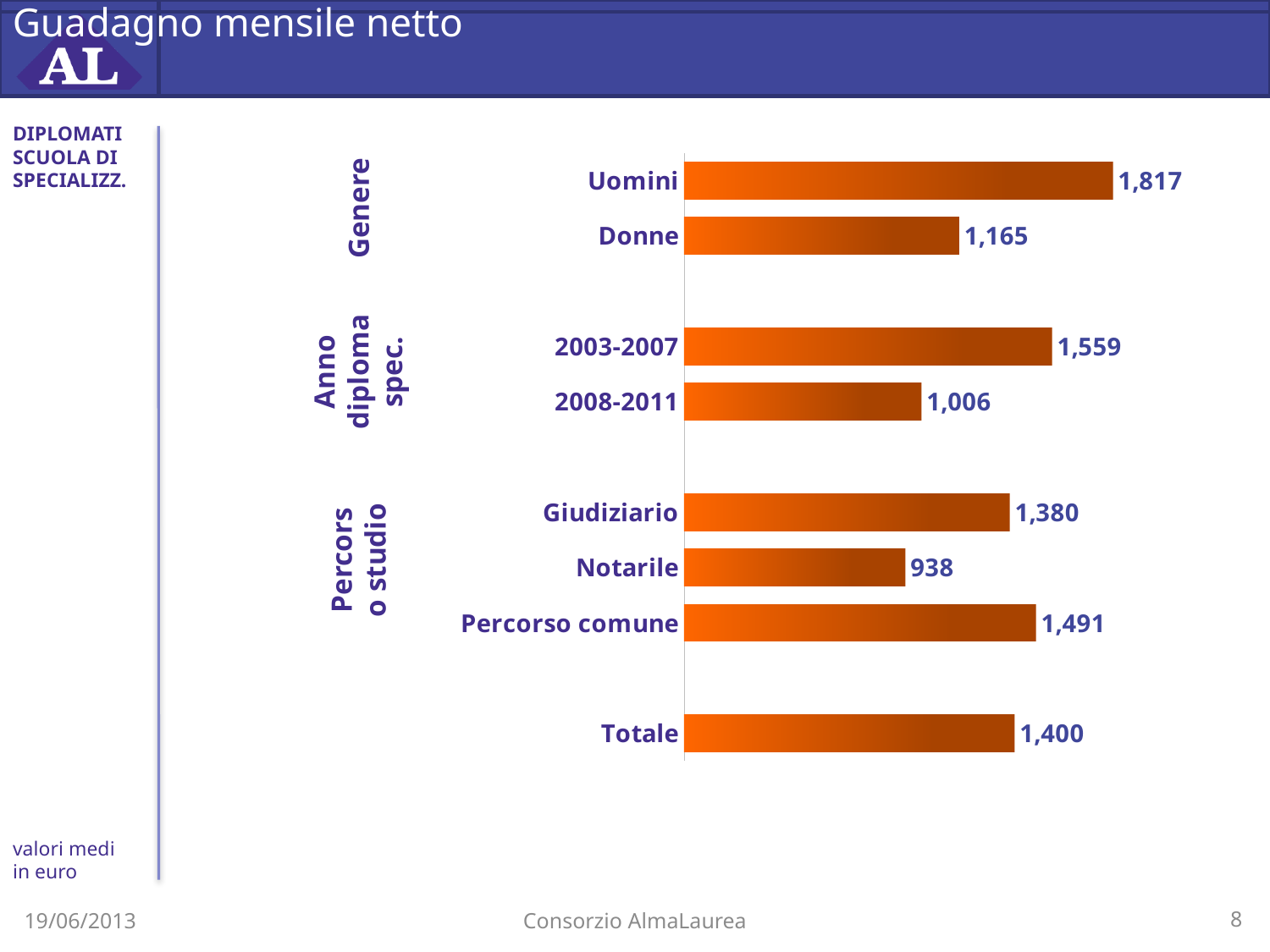
What is the value for Notarile? 938 Which category has the highest value? Uomini What is the value for Donne? 1,165 How many bars are plotted in the chart? 8 Which is larger, the value for Giudiziario or the value for Percorso comune? Percorso comune What is the value for 2008-2011? 1,006 What is the value for Totale? 1,400 What kind of chart is shown on the slide? Bar chart What is the difference between the values for 2003-2007 and 2008-2011? 553 What is the difference between the values for Uomini and Donne? 652 Which category has the lowest value? Notarile What is the value for Uomini? 1,817